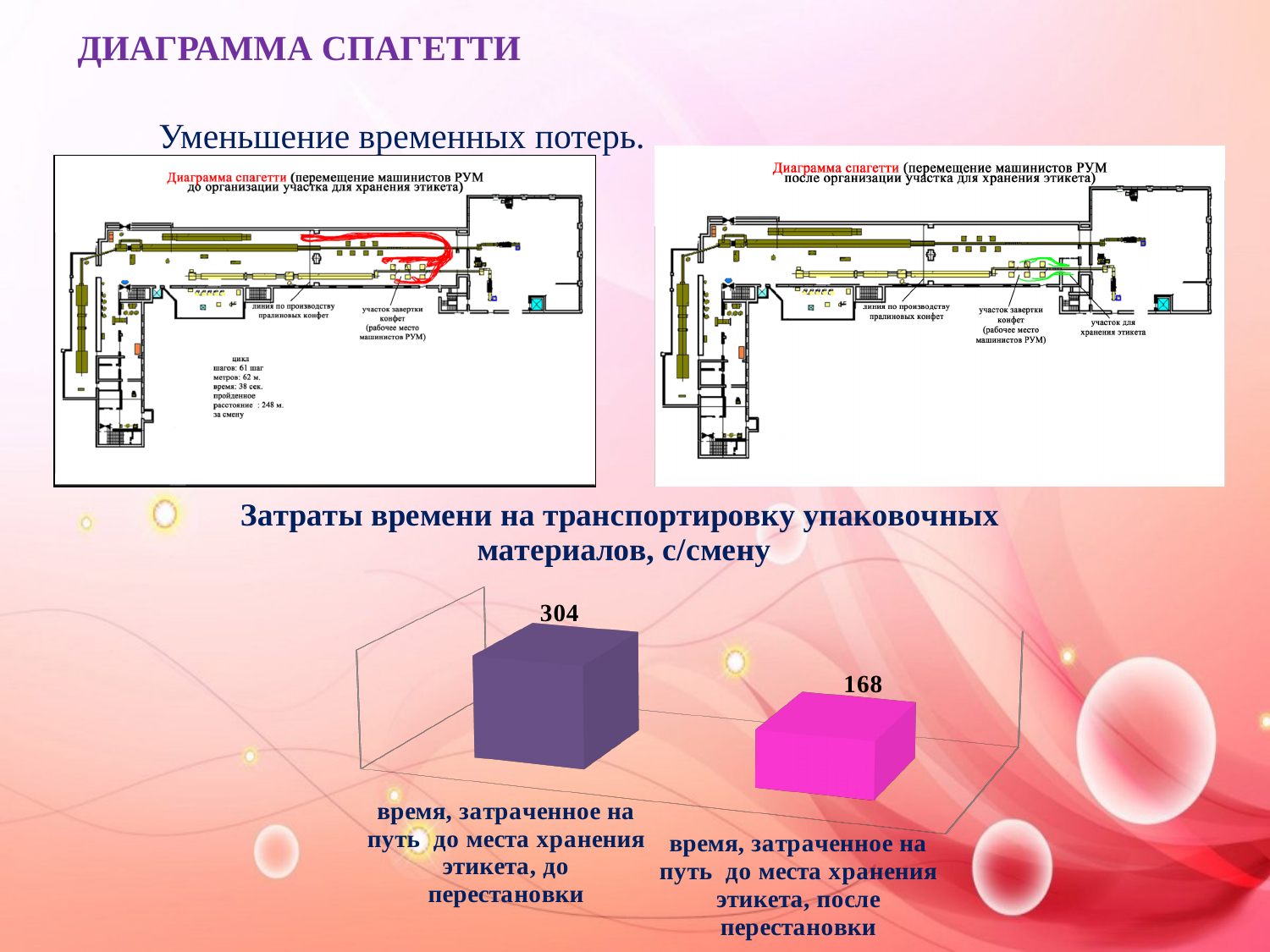
What colour is the bar for the time after the rearrangement (после перестановки)? magenta (pink) Which category has the highest value in the bar chart? время, затраченное на путь до места хранения этикета, до перестановки What is the value for 'время, затраченное на путь до места хранения этикета, после перестановки'? 168 Which is larger: the value before the rearrangement (до перестановки) or after the rearrangement (после перестановки)? до перестановки What is the title of the bar chart? Затраты времени на транспортировку упаковочных материалов, с/смену What is the difference between the time before the rearrangement (до перестановки) and after the rearrangement (после перестановки)? 136 Which category has the lowest value in the bar chart? время, затраченное на путь до места хранения этикета, после перестановки Do the values rise or fall from the left bar to the right bar? fall What type of chart is shown at the bottom of the slide? bar chart What is the value for 'время, затраченное на путь до места хранения этикета, до перестановки'? 304 How many bars are shown in the bar chart? 2